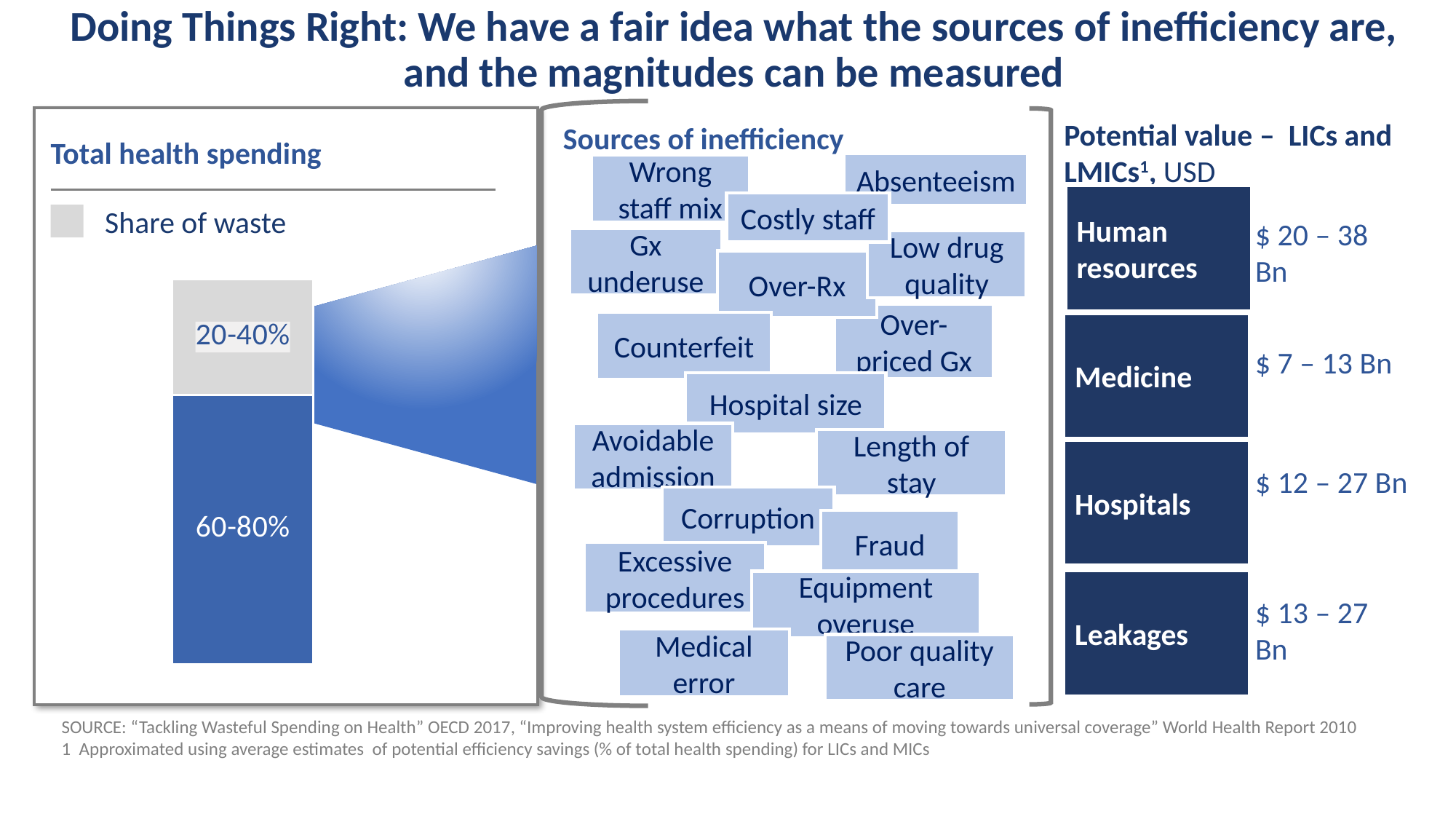
In the "Total health spending" chart, what value is printed on the grey segment labelled as share of waste? 20-40% In the "Potential value – LICs and LMICs, USD" panel on the right, what is the value for Medicine? $ 7 – 13 Bn In the "Total health spending" chart, what value is printed on the dark blue segment of the bar? 60-80% What type of chart is shown under the title "Total health spending"? Stacked bar chart How many segments make up the bar in the "Total health spending" chart? 2 In the "Potential value – LICs and LMICs, USD" panel on the right, which category has the lowest potential value range? Medicine In the "Potential value – LICs and LMICs, USD" panel on the right, what is the value for Human resources? $ 20 – 38 Bn In the "Total health spending" chart, which segment is larger, the grey share of waste or the dark blue segment? The dark blue segment (60-80%) In the "Potential value – LICs and LMICs, USD" panel on the right, what is the value for Hospitals? $ 12 – 27 Bn In the "Total health spending" chart, is the share of waste segment positioned at the top or the bottom of the bar? Top In the "Total health spending" chart, what does the grey colour represent according to the legend? Share of waste What is the title of the bar chart on the left of the slide? Total health spending